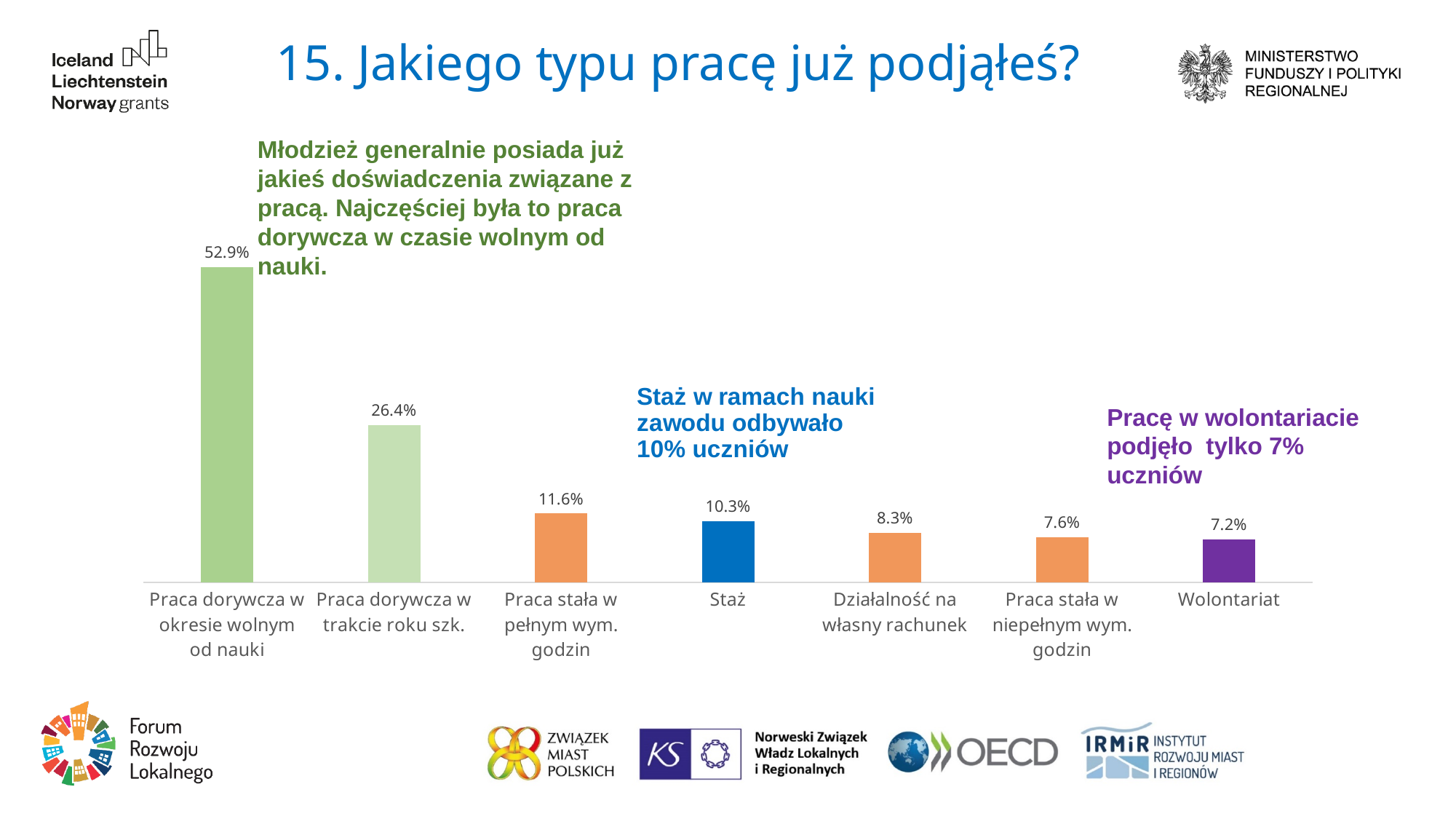
How many categories are shown in the chart? 7 What is the difference between "Praca dorywcza w okresie wolnym od nauki" and "Praca dorywcza w trakcie roku szk."? 26.5% What is the value for "Staż"? 10.3% What is the value for "Wolontariat"? 7.2% What colour is the bar for "Wolontariat"? Purple What is the value for "Działalność na własny rachunek"? 8.3% Which category has the highest value? Praca dorywcza w okresie wolnym od nauki Which is larger: "Staż" or "Działalność na własny rachunek"? Staż Which category has the lowest value? Wolontariat What is the difference between "Praca stała w pełnym wym. godzin" and "Praca stała w niepełnym wym. godzin"? 4.0% What is the value for "Praca dorywcza w okresie wolnym od nauki"? 52.9% What kind of chart is shown on the slide? Bar chart